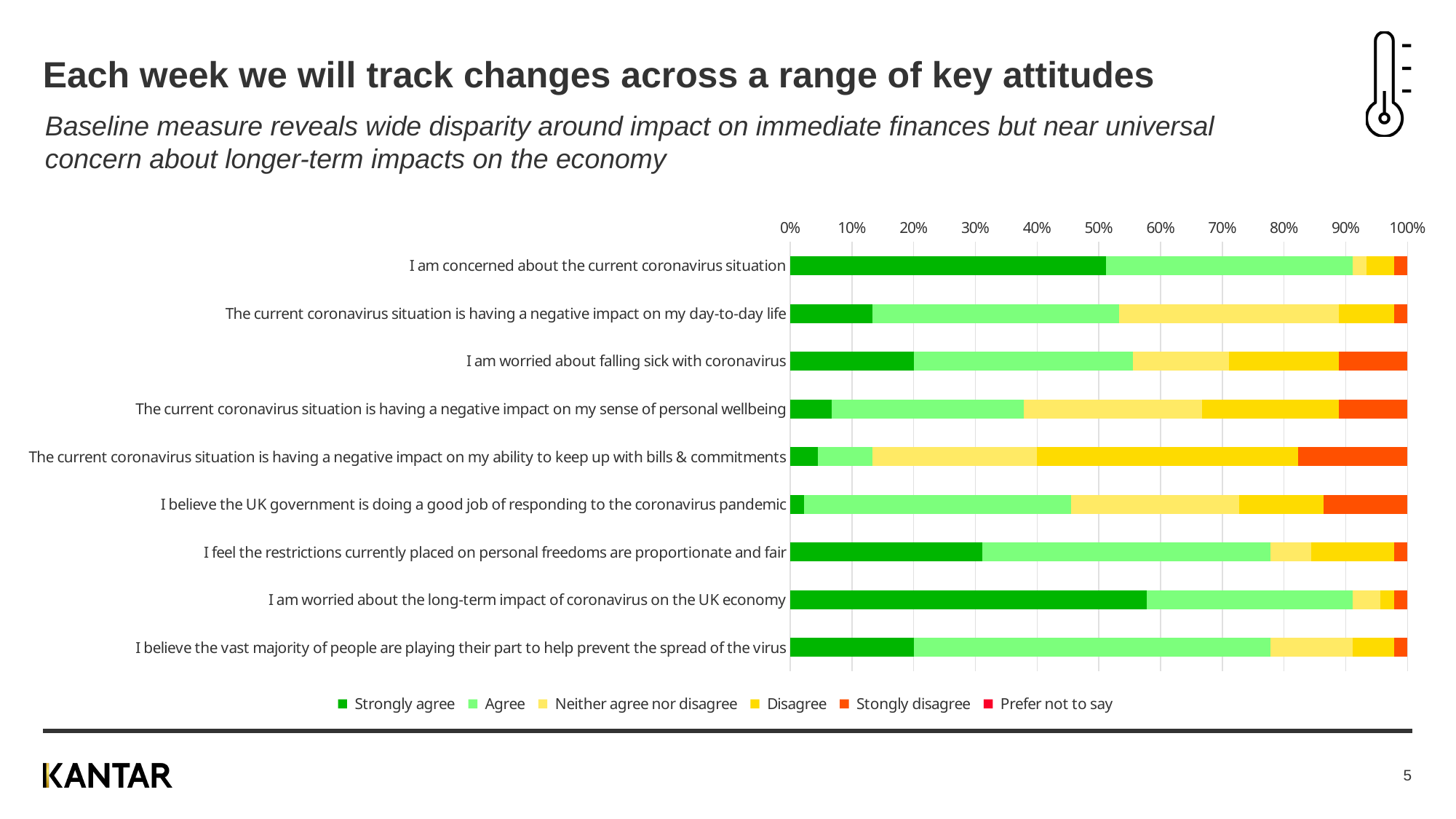
Is the 'Strongly agree' share for 'The current coronavirus situation is having a negative impact on my day-to-day life' greater or less than 20%? less Which has the larger 'Strongly agree' share: 'I am concerned about the current coronavirus situation' or 'I feel the restrictions currently placed on personal freedoms are proportionate and fair'? I am concerned about the current coronavirus situation What is the last entry in the chart legend? Prefer not to say Is the 'Strongly agree' share for 'The current coronavirus situation is having a negative impact on my ability to keep up with bills & commitments' greater or less than 10%? less How many series does the chart legend list? 6 Which statement has the smallest 'Strongly agree' share? I believe the UK government is doing a good job of responding to the coronavirus pandemic Which statement has the largest 'Strongly agree' share? I am worried about the long-term impact of coronavirus on the UK economy What kind of chart is shown on the slide? Stacked bar chart How many statements (categories) are plotted in the chart? 9 Is the 'Strongly agree' share for 'I am worried about the long-term impact of coronavirus on the UK economy' greater or less than 50%? greater Which statement has the largest 'Stongly disagree' share? The current coronavirus situation is having a negative impact on my ability to keep up with bills & commitments What is the first entry in the chart legend? Strongly agree